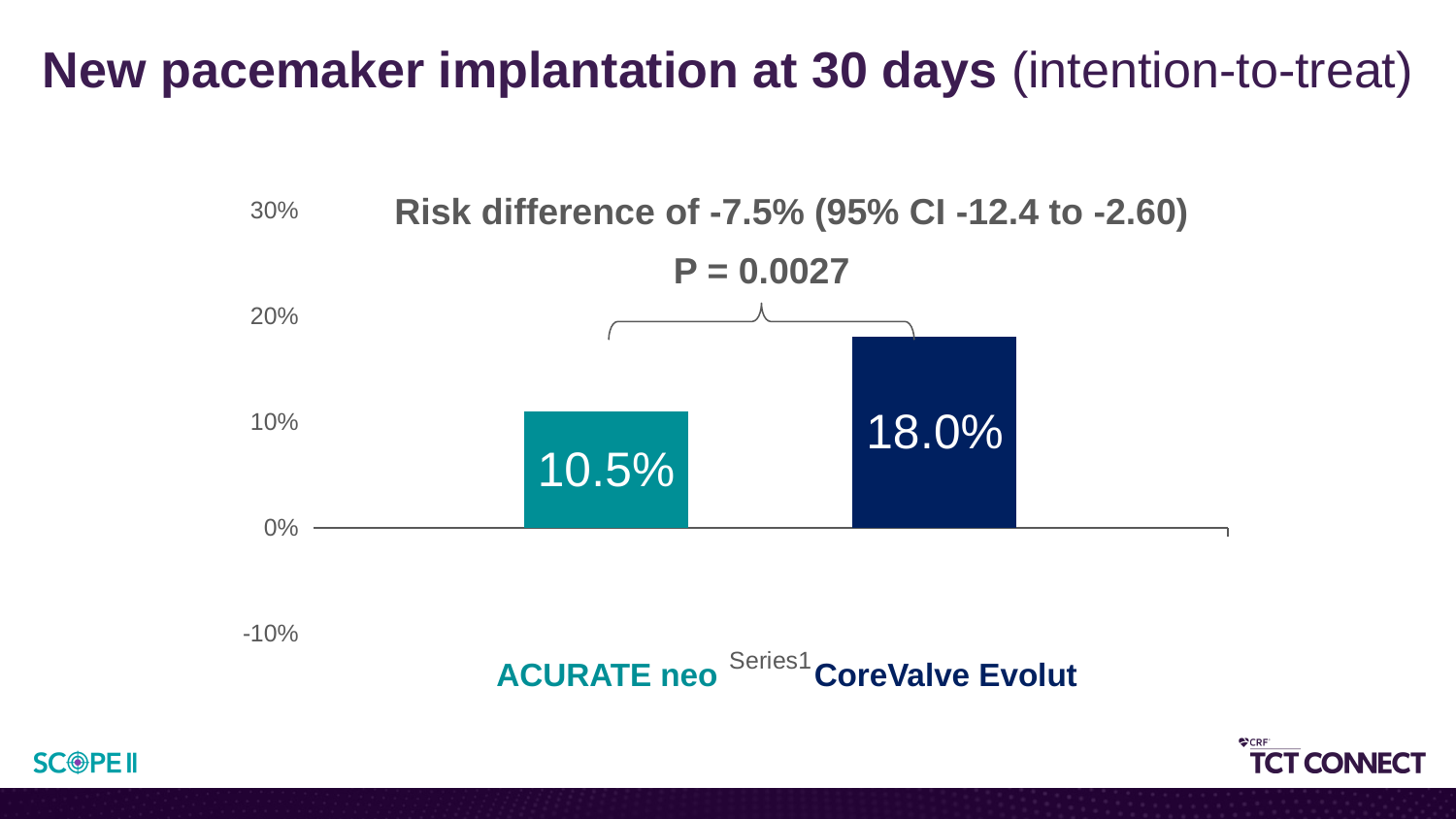
What kind of chart is shown on the slide? bar chart What is the value for CoreValve Evolut? 18.0% What P value is shown on the chart? P = 0.0027 Is the value for ACURATE neo greater or less than 10%? greater Is the value for CoreValve Evolut greater or less than 20%? less Is the value for ACURATE neo larger or smaller than the value for CoreValve Evolut? smaller Which group has the higher rate of new pacemaker implantation at 30 days? CoreValve Evolut How many bars are plotted in the chart? 2 What is the difference between the CoreValve Evolut and ACURATE neo values? 7.5% What is the value for ACURATE neo? 10.5% Which group has the lower rate of new pacemaker implantation at 30 days? ACURATE neo What risk difference is stated above the bars? -7.5% (95% CI -12.4 to -2.60)